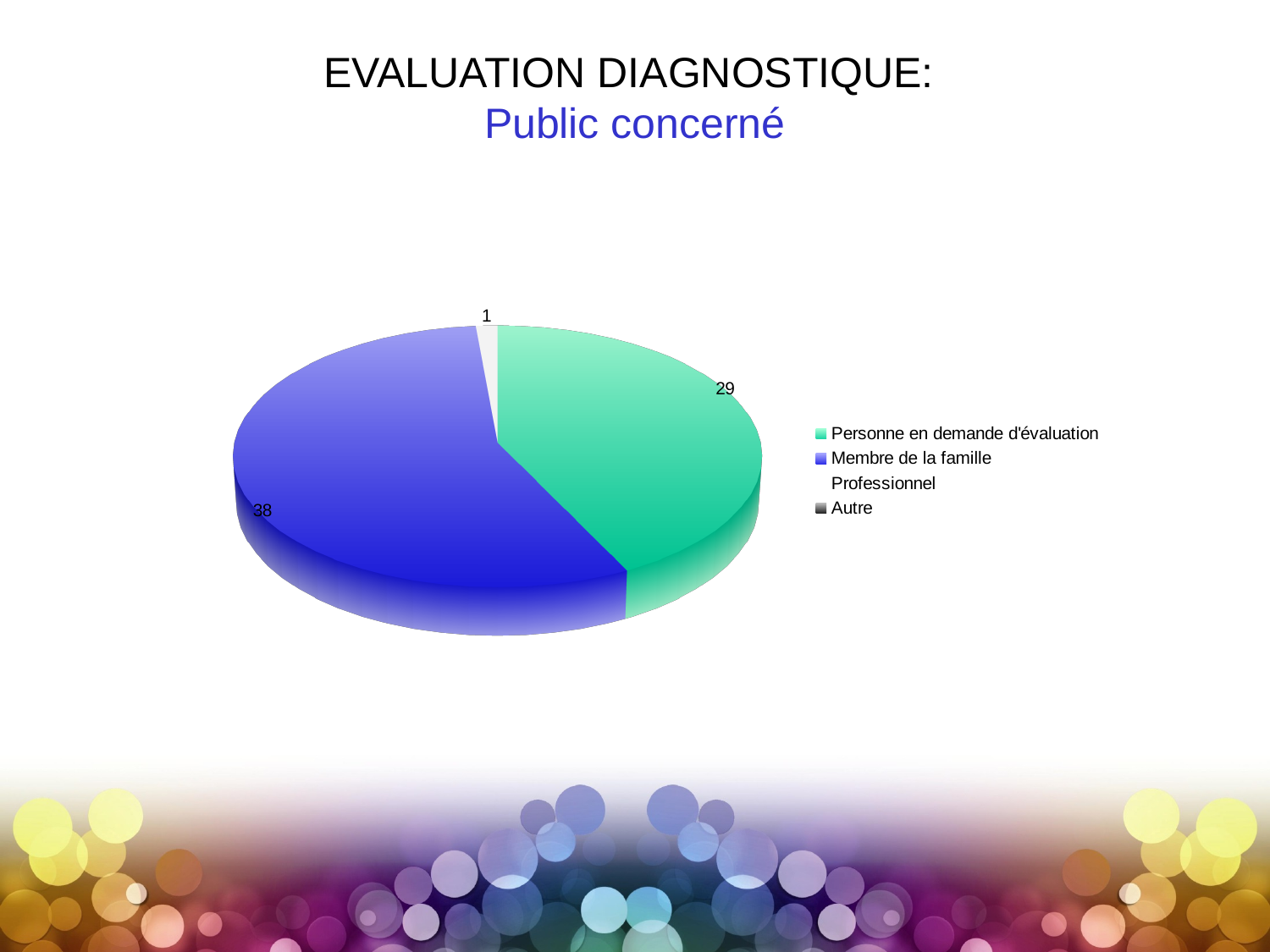
What value is shown for Membre de la famille? 38 What colour is the slice for Personne en demande d'évaluation? Green What is the smallest value labelled on the pie? 1 Which is larger, Membre de la famille or Personne en demande d'évaluation? Membre de la famille What value is shown for Personne en demande d'évaluation? 29 How many data labels are printed on the pie? 3 How many entries does the legend list? 4 What is the difference between the values for Membre de la famille and Personne en demande d'évaluation? 9 What colour is the slice for Membre de la famille? Blue Which category has the largest slice of the pie? Membre de la famille What kind of chart is shown on the slide? Pie chart